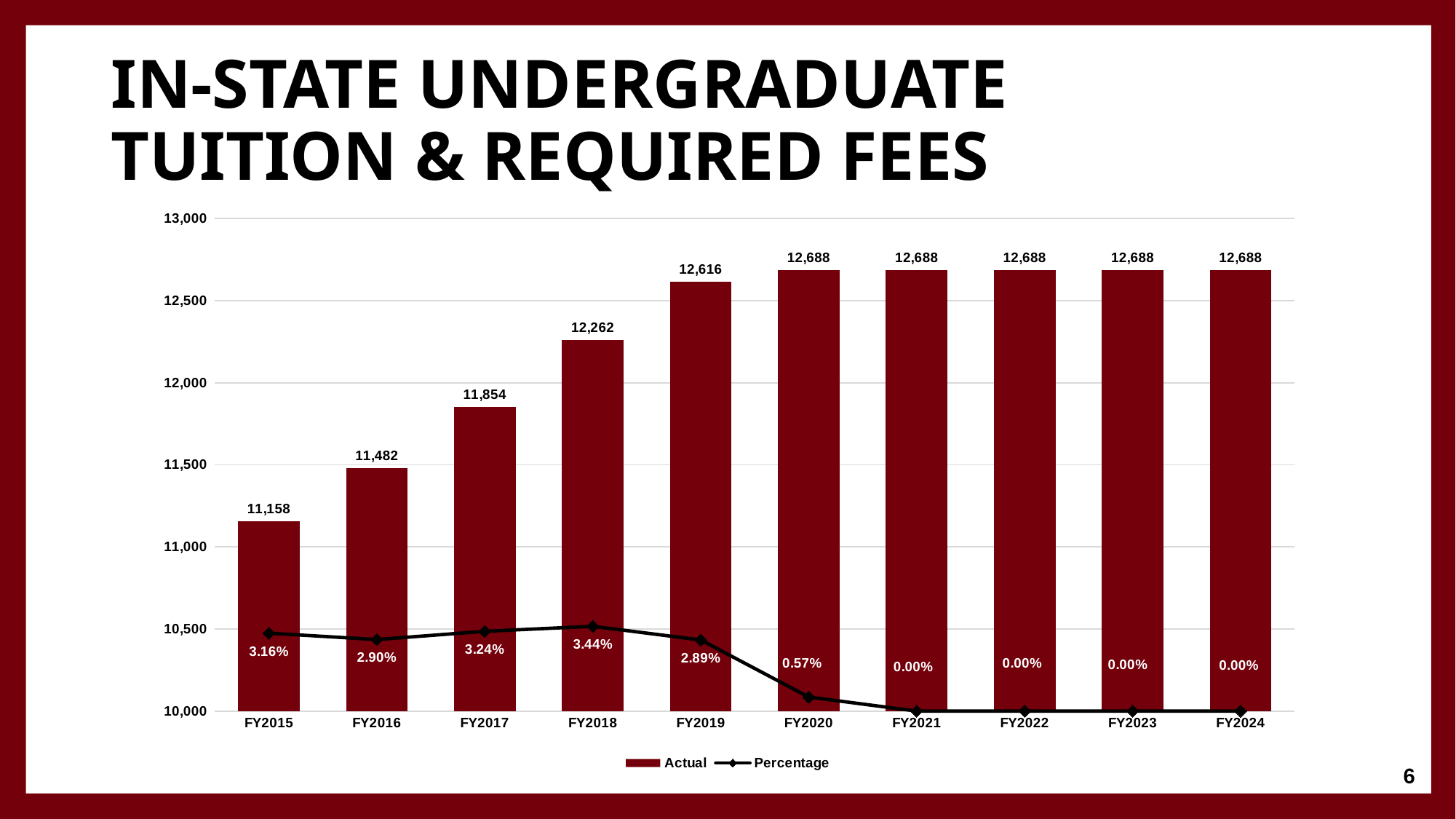
Do the Actual values rise or fall from FY2015 to FY2020? Rise What is the difference between the Actual values for FY2019 and FY2018? 354 How many fiscal years are shown on the x axis? 10 What is the Actual value for FY2018? 12,262 What is the Percentage value for FY2019? 2.89% Which fiscal year has the lowest Actual value? FY2015 What is the Percentage value for FY2020? 0.57% What kind of chart is used to show the Actual series? Bar chart How many series does the legend list? 2 Which is larger, the Actual value for FY2016 or for FY2017? FY2017 What is the Actual value for FY2015? 11,158 Which fiscal year has the highest Percentage value? FY2018